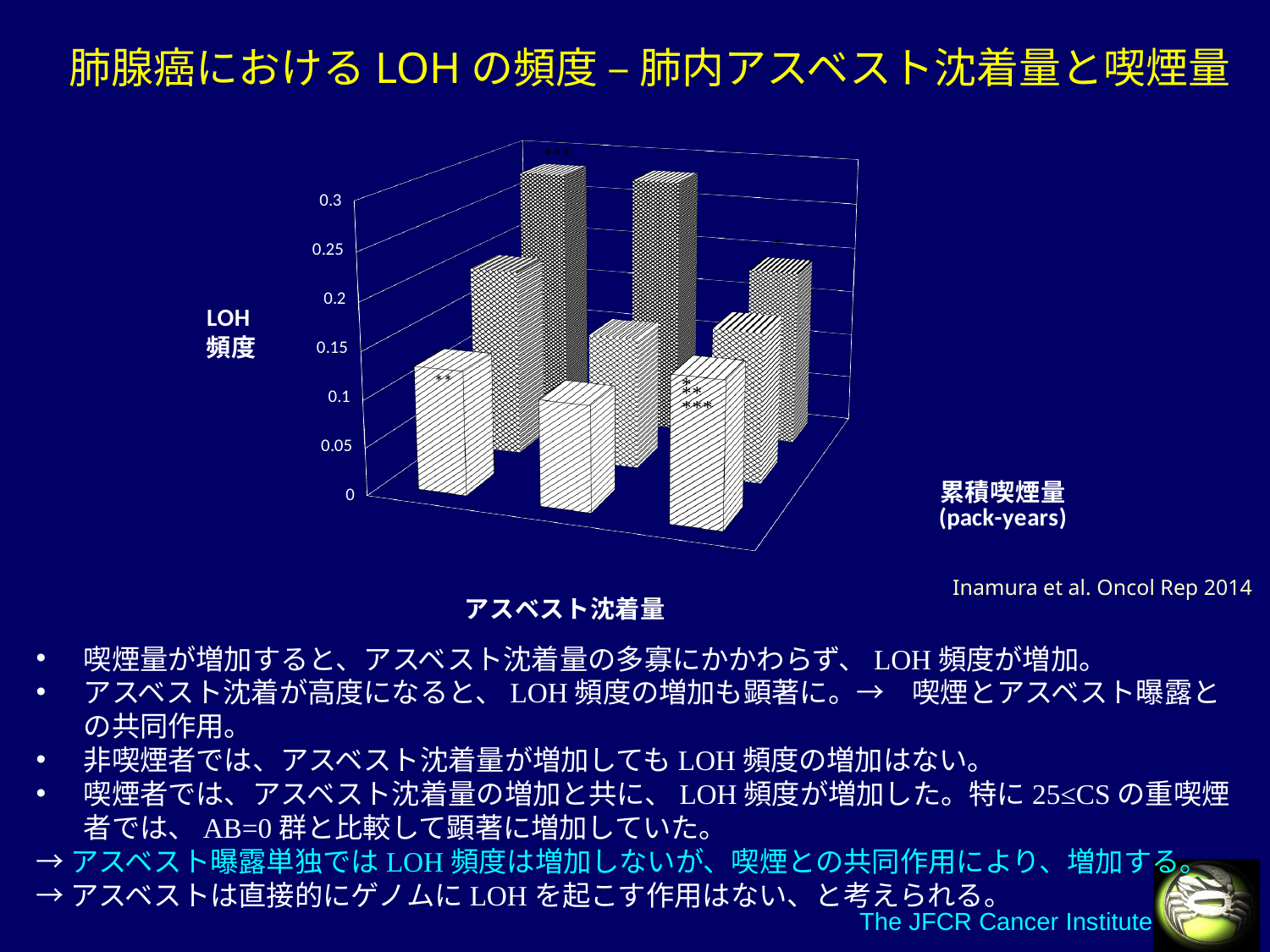
What kind of chart is shown on the slide? bar chart Is the value of the tallest bar in the chart greater or less than 0.25? greater How many bars are plotted in the chart? 9 What is the label of the vertical axis of the chart? LOH 頻度 What is the highest tick value shown on the vertical axis of the chart? 0.3